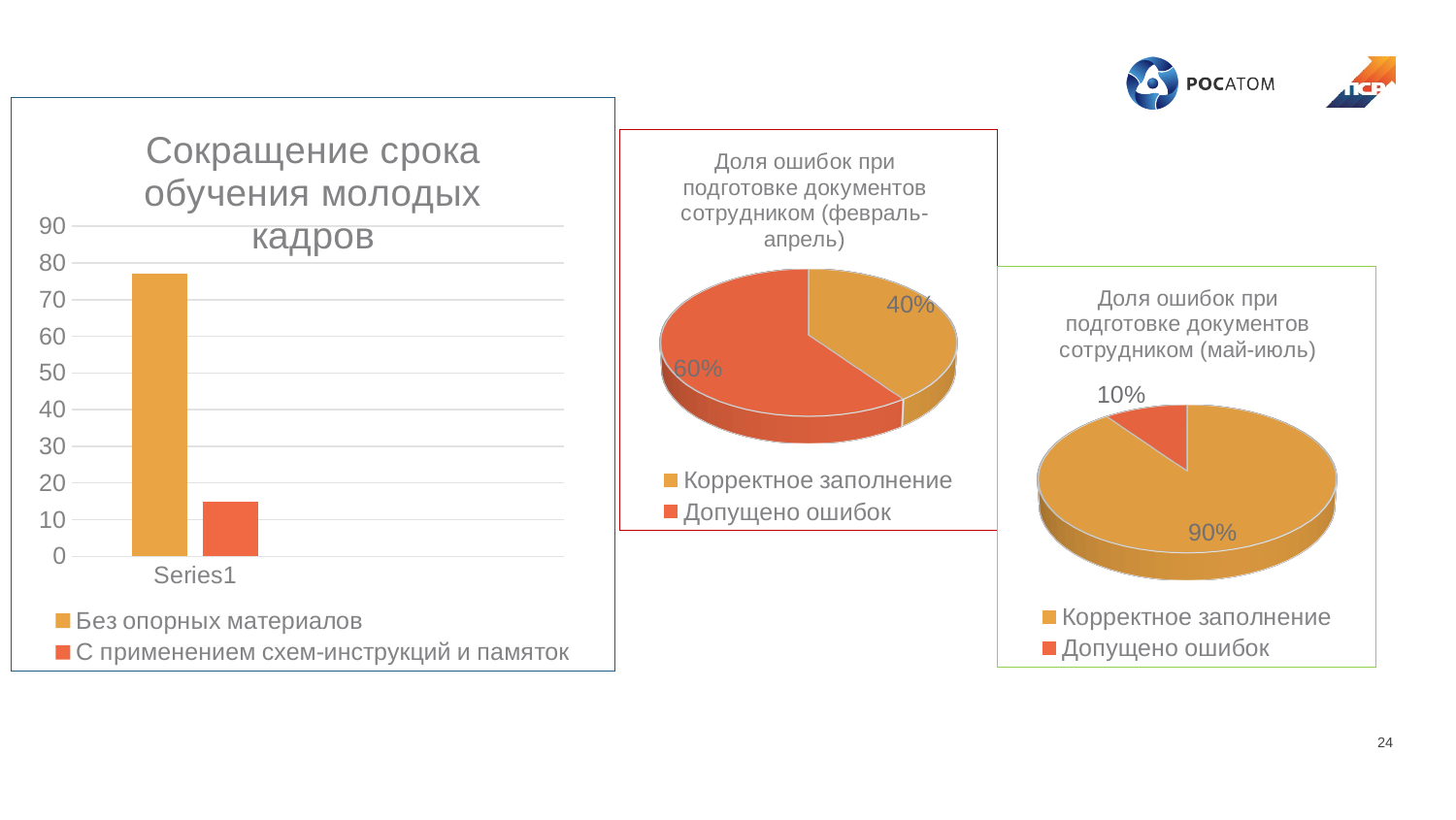
In the chart titled "Сокращение срока обучения молодых кадров", how many series does the legend list? 2 In the chart titled "Сокращение срока обучения молодых кадров", what is the highest value shown on the vertical axis? 90 What is the difference between the "Допущено ошибок" share in the февраль-апрель pie chart and in the май-июль pie chart? 50% In the pie chart for февраль-апрель, what share is "Допущено ошибок"? 60% In the chart titled "Сокращение срока обучения молодых кадров", which series has the taller bar? Без опорных материалов In the pie chart for май-июль, what share is "Корректное заполнение"? 90% What kind of chart is the chart titled "Сокращение срока обучения молодых кадров"? bar chart In the pie chart for май-июль, what share is "Допущено ошибок"? 10% In the chart titled "Сокращение срока обучения молодых кадров", is the value for "Без опорных материалов" greater or less than 70? greater In the chart titled "Сокращение срока обучения молодых кадров", is the value for "С применением схем-инструкций и памяток" greater or less than 20? less What kind of chart is the chart titled "Доля ошибок при подготовке документов сотрудником (февраль-апрель)"? pie chart